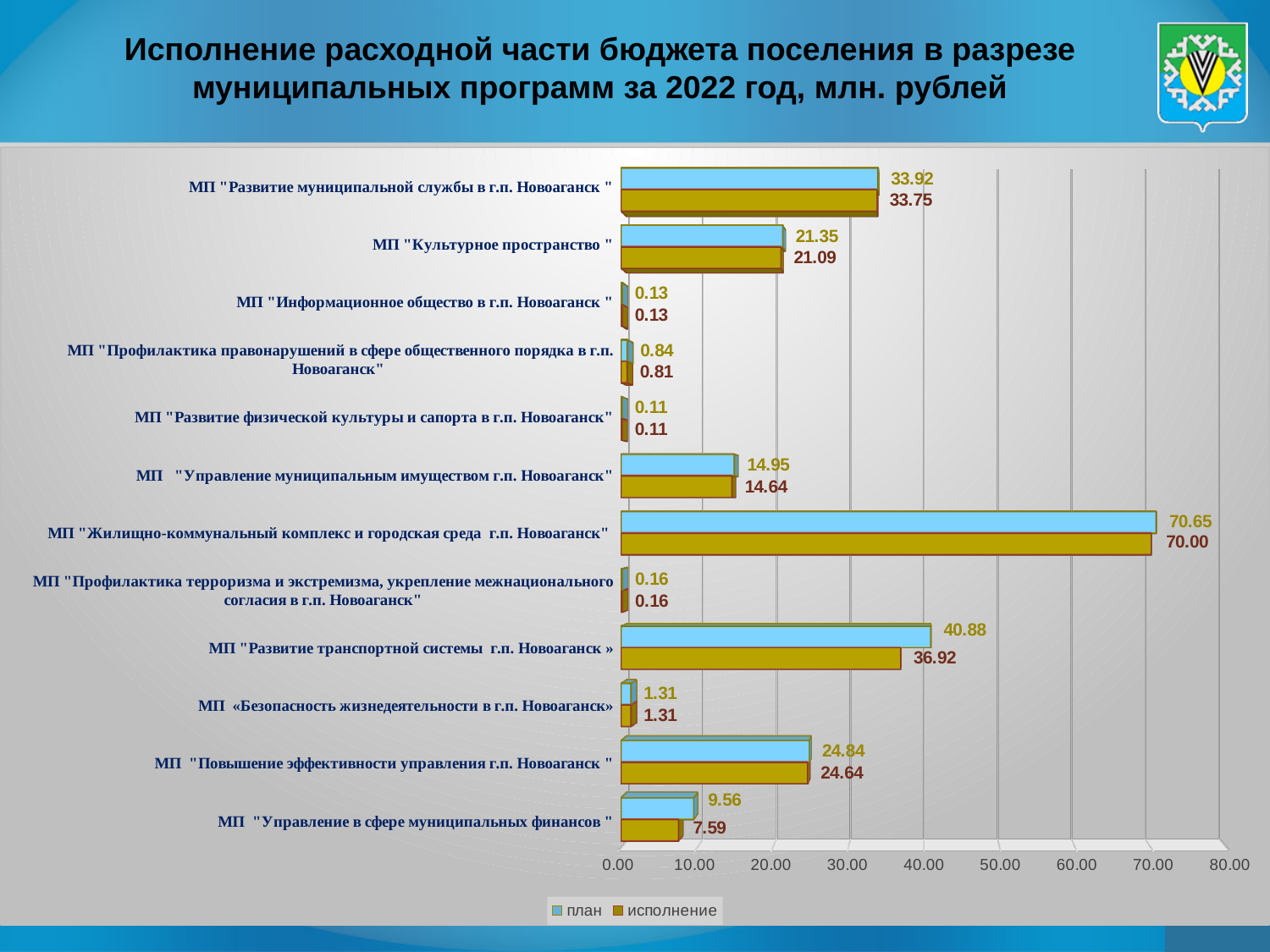
Which is larger: the план value for МП "Повышение эффективности управления г.п. Новоаганск" or the план value for МП "Культурное пространство"? МП "Повышение эффективности управления г.п. Новоаганск" What are the two series named in the legend? план and исполнение How many municipal programmes (categories) are plotted on the chart? 12 What is the исполнение value for МП "Культурное пространство"? 21.09 Which programme has the highest план value? МП "Жилищно-коммунальный комплекс и городская среда г.п. Новоаганск" Which programme has the lowest исполнение value? МП "Развитие физической культуры и сапорта в г.п. Новоаганск" What is the difference between план and исполнение for МП "Развитие транспортной системы г.п. Новоаганск"? 3.96 What type of chart is shown on the slide? bar chart What is the план (plan) value for МП "Развитие транспортной системы г.п. Новоаганск"? 40.88 Is the исполнение value for МП "Жилищно-коммунальный комплекс и городская среда г.п. Новоаганск" greater or less than 60.00? greater How many series does the legend list? 2 What is the исполнение (execution) value for МП "Управление в сфере муниципальных финансов"? 7.59